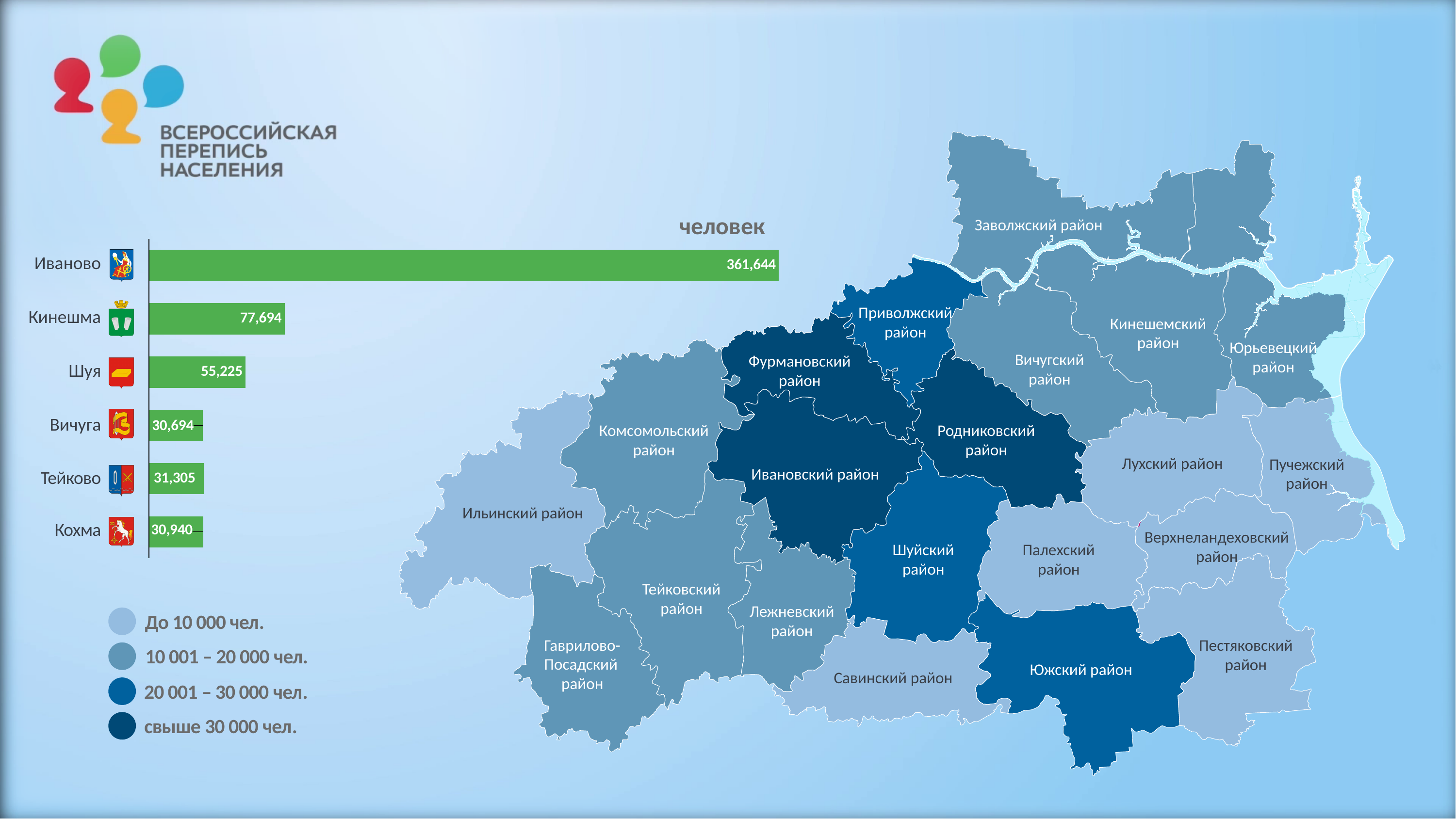
What is the difference between the values for Кинешма and Шуя in the bar chart? 22,469 What is the difference between the values for Тейково and Кохма in the bar chart? 365 Which city has the highest value in the bar chart? Иваново What is the title shown above the bar chart? человек What type of chart is used to show the city populations? bar chart How many cities are shown in the bar chart? 6 Which city has the lowest value in the bar chart? Вичуга Which has a larger value in the bar chart, Шуя or Кинешма? Кинешма What is the value shown for Тейково in the bar chart? 31,305 What is the value shown for Шуя in the bar chart? 55,225 What is the value shown for Кинешма in the bar chart? 77,694 What is the value shown for Иваново in the bar chart? 361,644